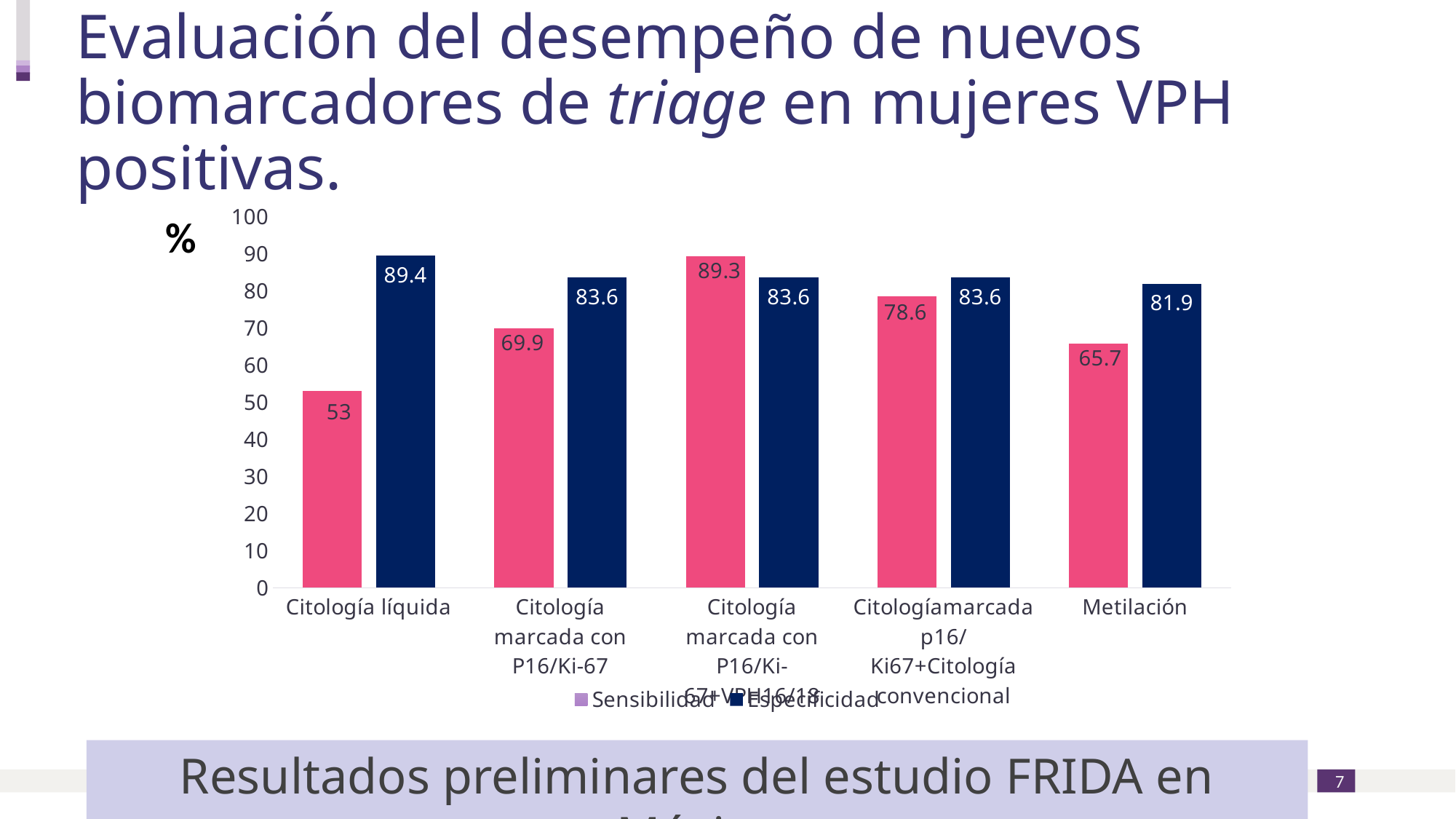
Which is larger for Metilación: Sensibilidad or Especificidad? Especificidad Which category has the lowest Sensibilidad value? Citología líquida Which category has the highest Especificidad value? Citología líquida What unit label is shown next to the y axis? % What is the difference between the Especificidad and Sensibilidad values for Citología líquida? 36.4 How many series does the legend list? 2 What kind of chart is shown on the slide? Bar chart Which category has the highest Sensibilidad value? Citología marcada con P16/Ki-67+VPH16/18 What is the Sensibilidad value for Citología marcada con P16/Ki-67? 69.9 What is the Sensibilidad value for Citología líquida? 53 How many categories are shown on the x axis? 5 What is the Especificidad value for Metilación? 81.9